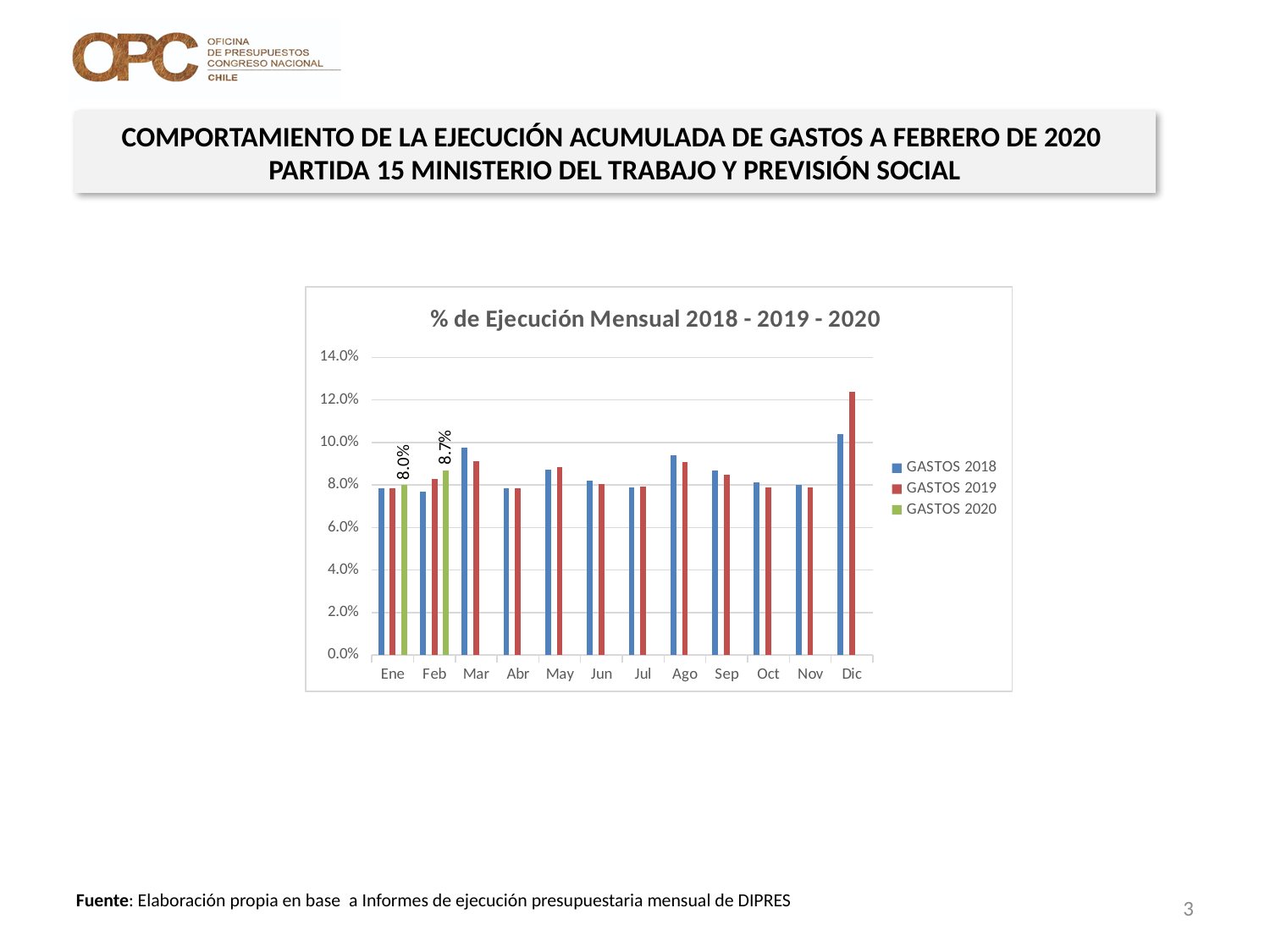
What is the value for GASTOS 2020 in Ene? 8.0% What kind of chart is shown on the slide? Bar chart What is the title of the chart? % de Ejecución Mensual 2018 - 2019 - 2020 What is the value for GASTOS 2020 in Feb? 8.7% How many months are shown on the x axis? 12 How many series does the legend list? 3 What is the difference between the GASTOS 2020 values for Feb and Ene? 0.7% Is the value for GASTOS 2018 in Feb greater or less than 8.0%? less Is the value for GASTOS 2019 in Dic greater or less than 12.0%? greater Which is larger for GASTOS 2020: the value for Ene or the value for Feb? Feb In which month is the GASTOS 2019 value highest? Dic In which month is the GASTOS 2018 value highest? Dic